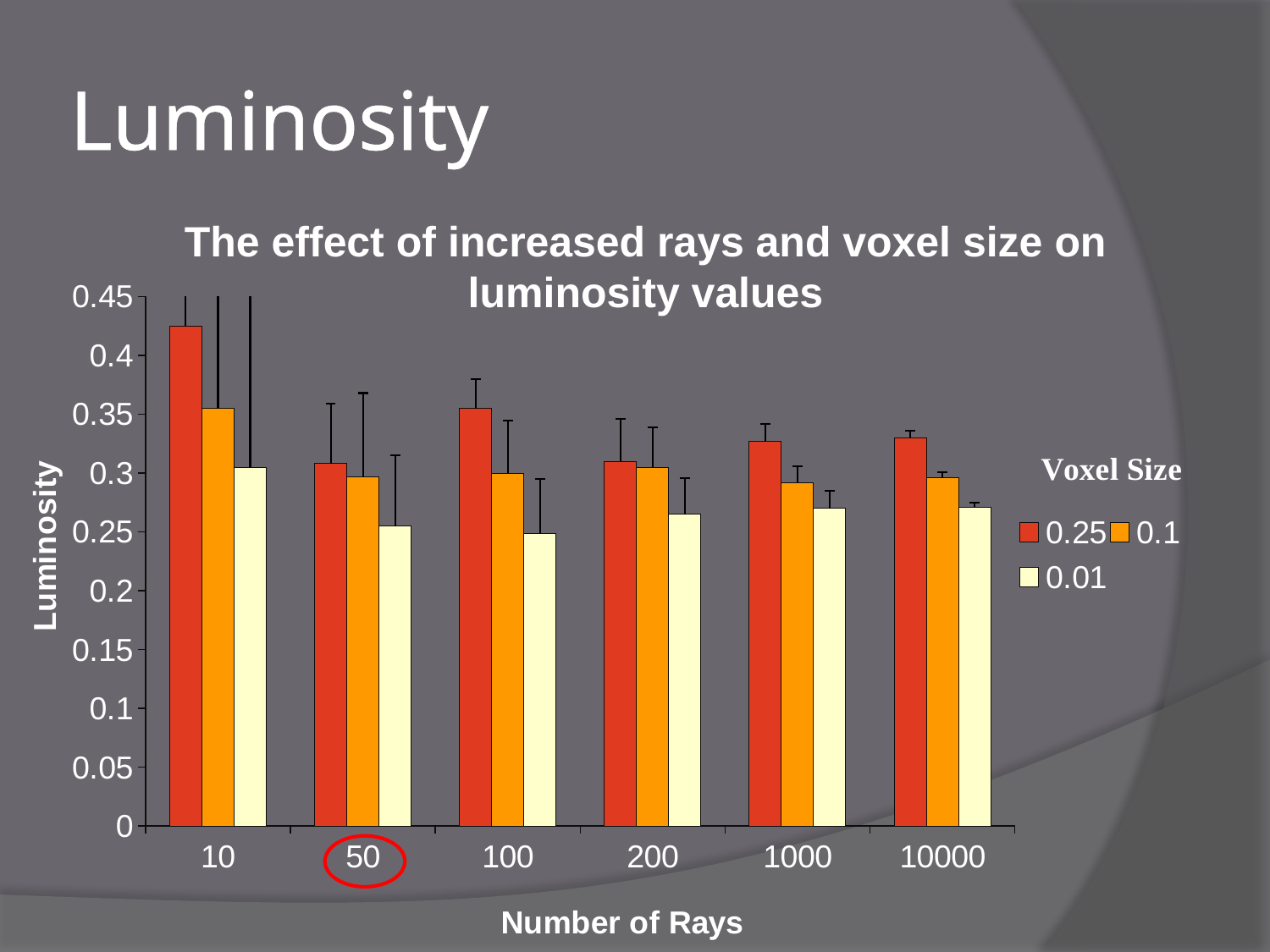
How many Number of Rays categories are shown on the x axis? 6 What kind of chart is shown on the slide? bar chart Is the value for voxel size 0.25 at 1000 rays greater or less than 0.3? greater At 10 rays, which voxel size has the larger luminosity, 0.25 or 0.01? 0.25 For which Number of Rays is the 0.25 voxel size bar the highest? 10 Which Number of Rays category is circled in red on the x axis? 50 How many series does the legend list? 3 At 100 rays, which voxel size has the larger luminosity, 0.25 or 0.1? 0.25 At 10 rays, which voxel size has the lowest luminosity? 0.01 Is the value for voxel size 0.01 at 50 rays greater or less than 0.3? less Is the value for voxel size 0.25 at 10 rays greater or less than 0.4? greater